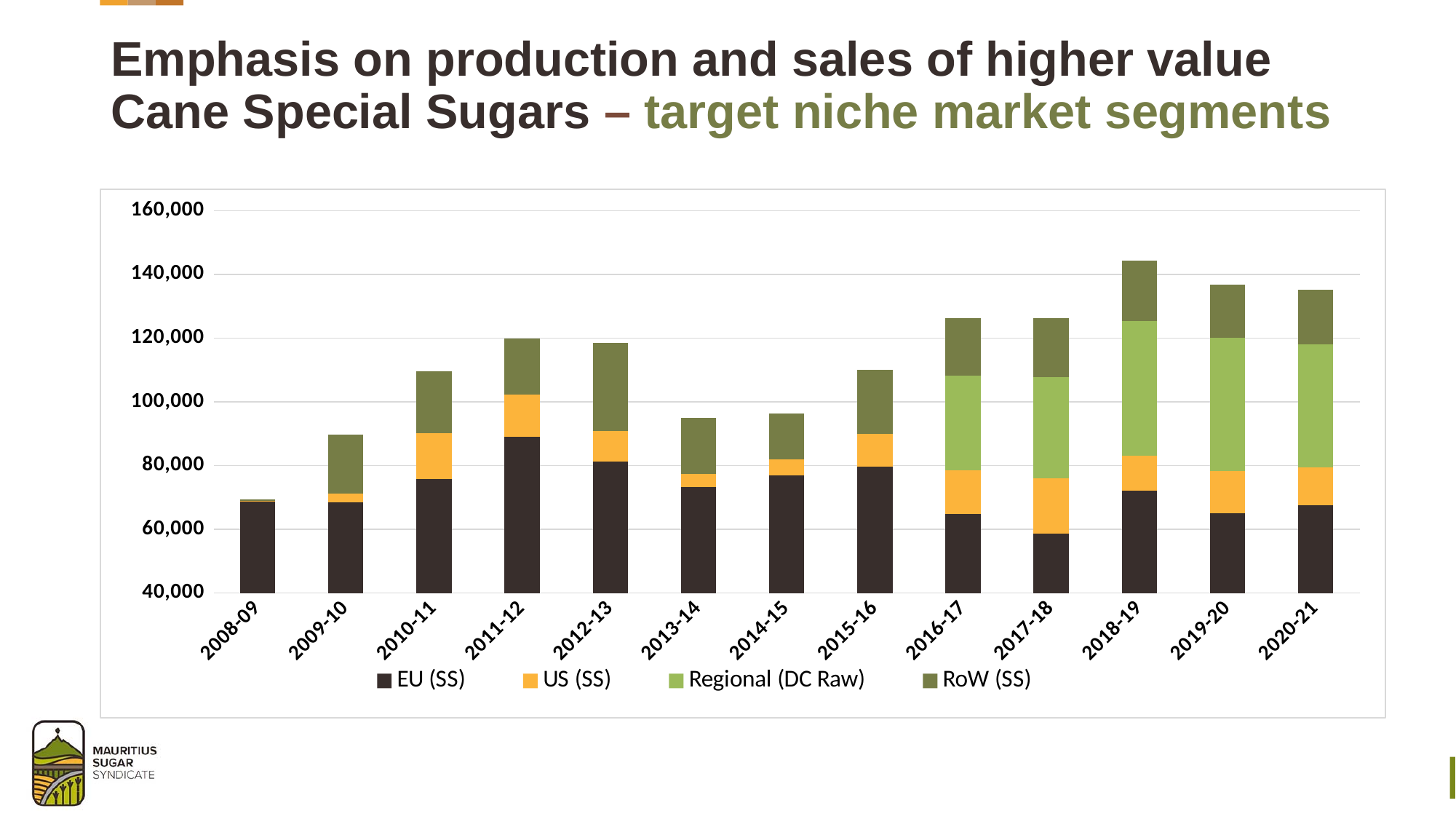
Which year has the tallest stacked bar (highest total) in the chart? 2018-19 Is the total for 2018-19 greater or less than 140,000? greater Which year has the larger total, 2009-10 or 2010-11? 2010-11 Is the total for 2008-09 greater or less than 80,000? less In which year does the Regional (DC Raw) series first appear in the chart? 2016-17 How many series does the chart's legend list? 4 Do the stacked bar totals rise or fall from 2016-17 to 2018-19? rise Which year has the shortest stacked bar (lowest total) in the chart? 2008-09 Is the total for 2013-14 greater or less than 100,000? less What kind of chart is shown on the slide? Stacked bar chart How many years (categories) are shown on the x axis of the chart? 13